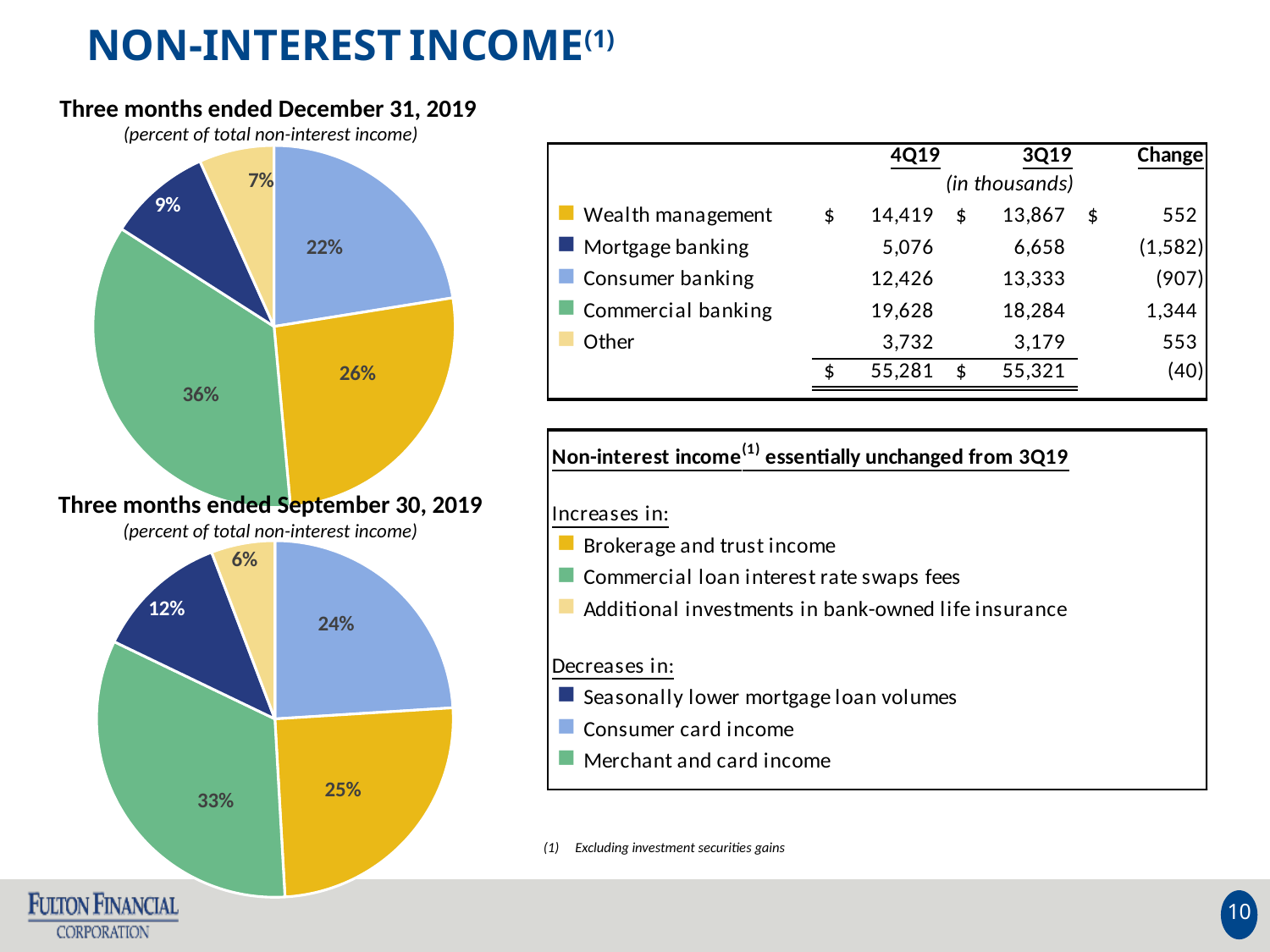
What is the subtitle shown in italics under each pie chart title? (percent of total non-interest income) In the pie chart for the three months ended December 31, 2019, what share does the gold (Wealth management) slice represent? 26% How many slices does each pie chart have? 5 What kind of charts are shown on the left of the slide? Pie charts In the pie chart for the three months ended September 30, 2019, what share does the light blue (Consumer banking) slice represent? 24% In the pie chart for the three months ended December 31, 2019, what share does the green (Commercial banking) slice represent? 36% Is the Mortgage banking share larger in the December 31, 2019 pie chart or the September 30, 2019 pie chart? September 30, 2019 What is the difference between the Commercial banking share in the December 31, 2019 pie chart and the September 30, 2019 pie chart? 3 percentage points In the pie chart for the three months ended September 30, 2019, which slice is the largest? Commercial banking (33%) In the pie chart for the three months ended December 31, 2019, which slice is the smallest? Other (7%)